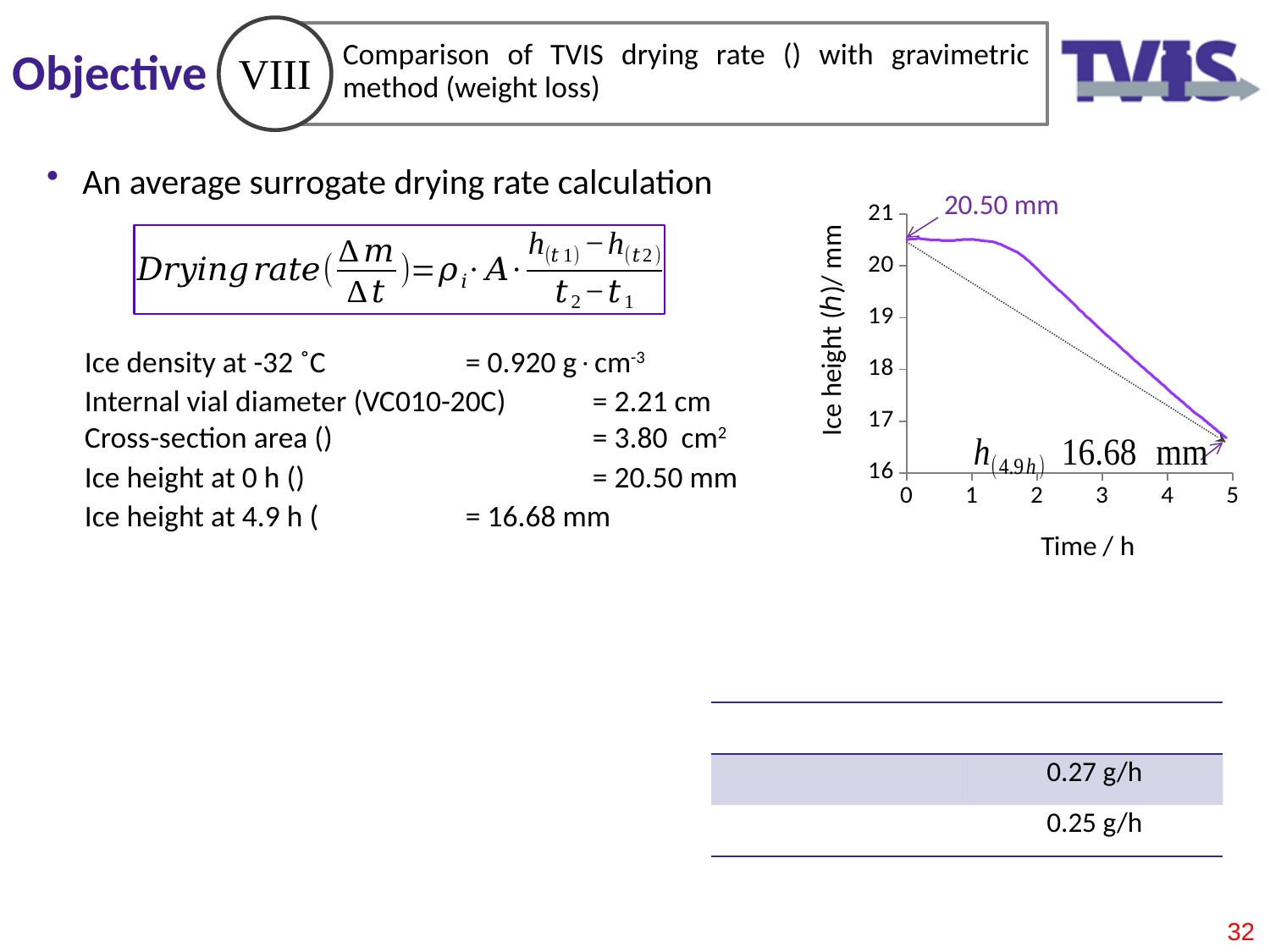
Is the ice height at 4 h greater or less than 18 mm? less Does the ice height rise or fall as time increases along the x axis? fall Is the ice height at 2 h greater or less than 19 mm? greater What is the label of the x axis of the chart? Time / h Which is larger, the ice height at 0 h or at 4.9 h? 0 h At what time is the ice height at its highest on the chart? 0 h By how much does the ice height decrease between 0 h and 4.9 h? 3.82 mm What is the ice height at 0 h according to the chart's data label? 20.50 mm Is the ice height at 3 h greater or less than 18 mm? greater What kind of chart is shown on the slide? line chart What is the ice height at 4.9 h according to the chart's data label? 16.68 mm What is the label of the y axis of the chart? Ice height (h)/ mm